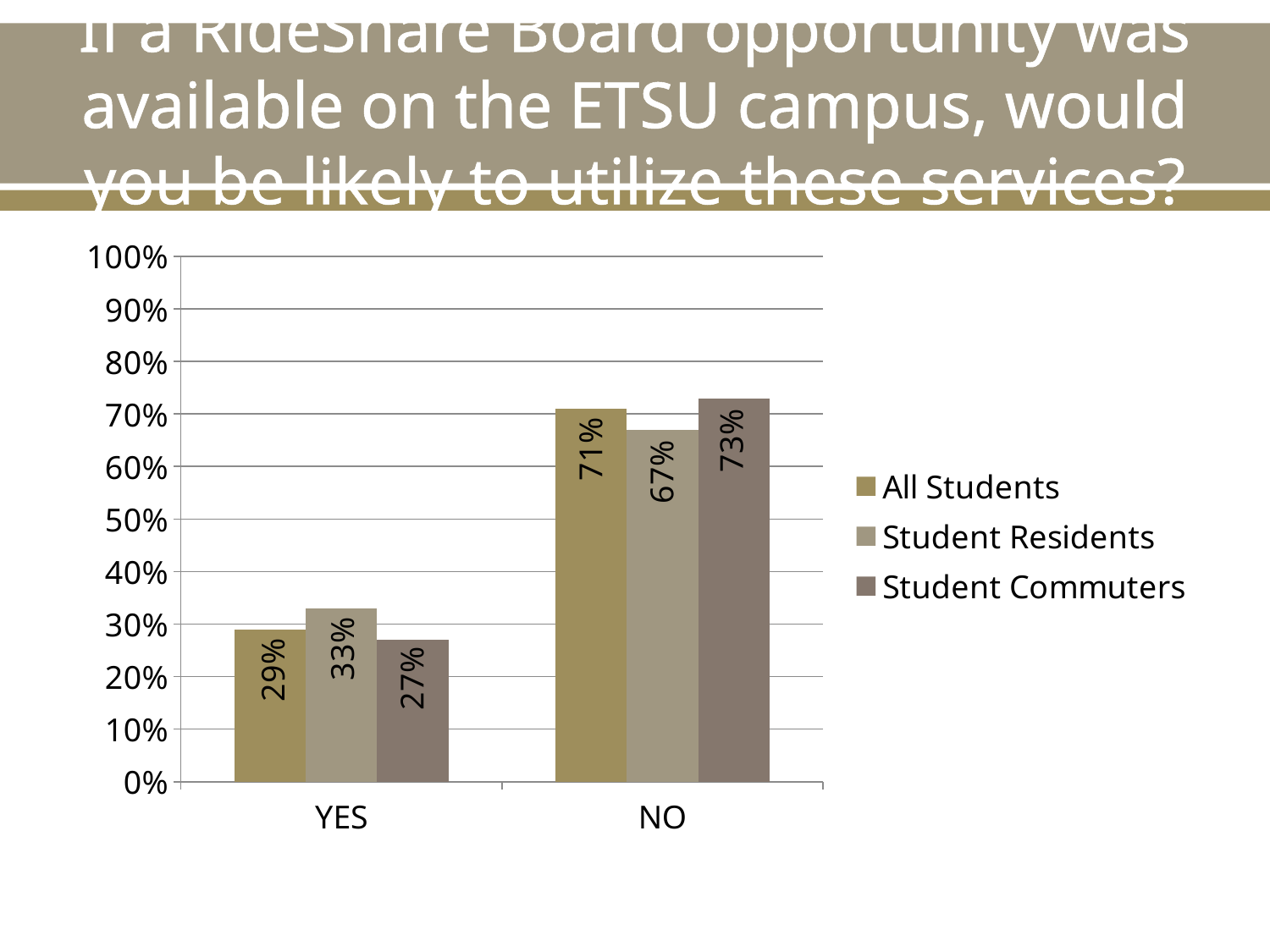
How many categories are shown on the x axis? 2 What percentage of All Students answered YES? 29% Which series has the lowest value for YES? Student Commuters Which is larger: the All Students value for YES or the All Students value for NO? NO Which series has the highest value for NO? Student Commuters What is the difference between the Student Residents and All Students values for YES? 4% How many series does the legend list? 3 What percentage of Student Residents answered YES? 33% What percentage of Student Residents answered NO? 67% What kind of chart is shown on the slide? Bar chart What percentage of Student Commuters answered NO? 73% What is the difference between the Student Commuters and Student Residents values for NO? 6%